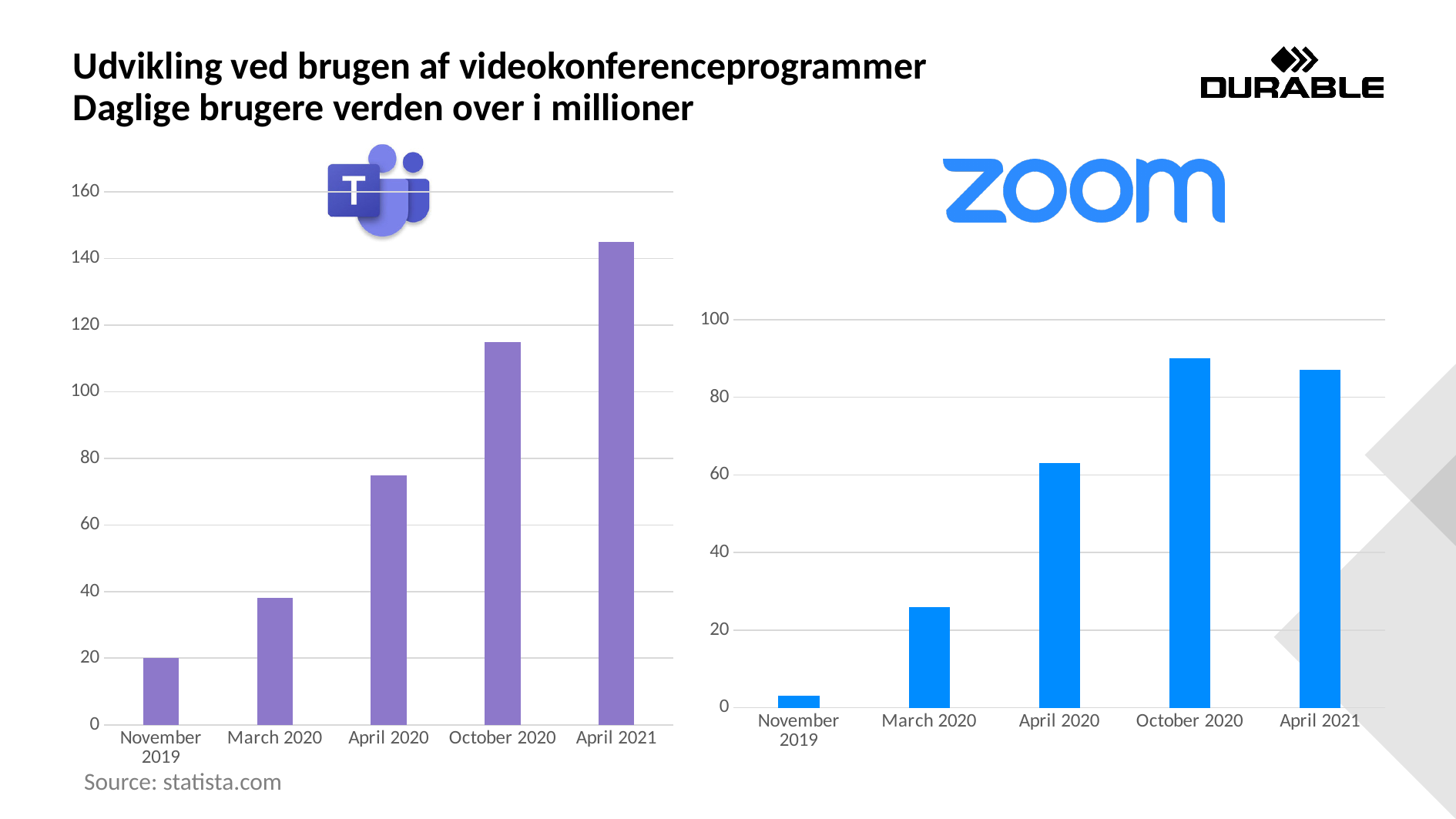
On the Zoom chart (right), which category has the highest value? October 2020 How many categories are shown on the Zoom chart (right)? 5 On the Microsoft Teams chart (left), which category has the lowest value? November 2019 On the Microsoft Teams chart (left), which category has the highest value? April 2021 On the Zoom chart (right), which category has the lowest value? November 2019 On the Microsoft Teams chart (left), what is the value for November 2019? 20 What kind of chart is the Microsoft Teams chart (left)? bar chart On the Microsoft Teams chart (left), is the value for April 2021 greater or less than 140? greater On the Microsoft Teams chart (left), do the values rise or fall from November 2019 to April 2021? rise On the Zoom chart (right), is the value for March 2020 greater or less than 40? less On the Zoom chart (right), is the value for April 2020 greater or less than 60? greater On the Microsoft Teams chart (left), which is larger, the value for October 2020 or the value for April 2020? October 2020